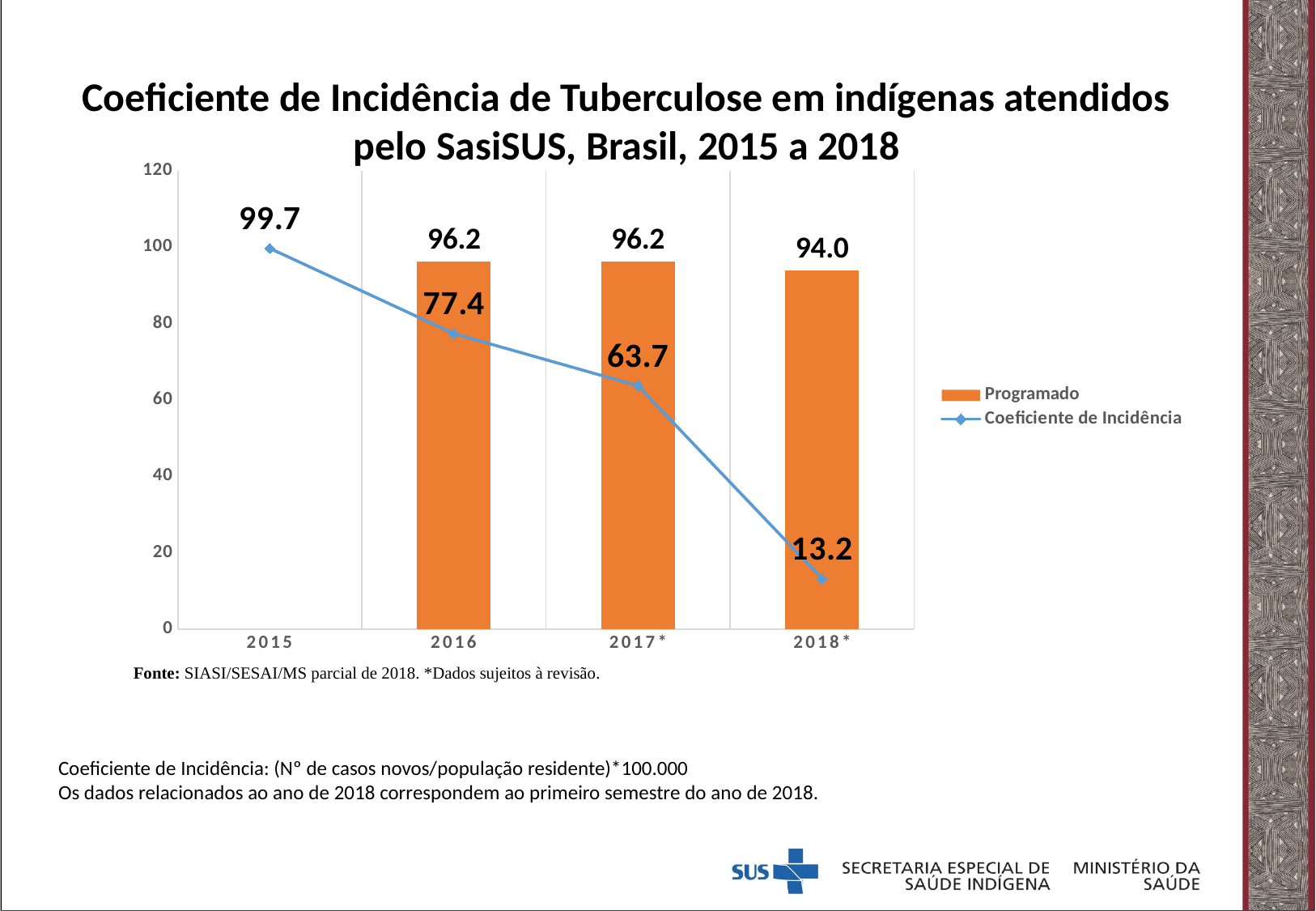
What is the difference between the Coeficiente de Incidência in 2016 and in 2017*? 13.7 Which year has the lowest Coeficiente de Incidência? 2018* What is the Programado value for 2016? 96.2 Which year has the highest Coeficiente de Incidência? 2015 What is the difference between the Programado value and the Coeficiente de Incidência value in 2018*? 80.8 What is the Programado value for 2018*? 94.0 How many series does the legend list? 2 Does the Coeficiente de Incidência rise or fall from 2015 to 2018*? Fall What is the Coeficiente de Incidência value for 2017*? 63.7 What is the Coeficiente de Incidência value for 2015? 99.7 Which is larger in 2016, the Programado value or the Coeficiente de Incidência? Programado How many years are shown on the x axis? 4